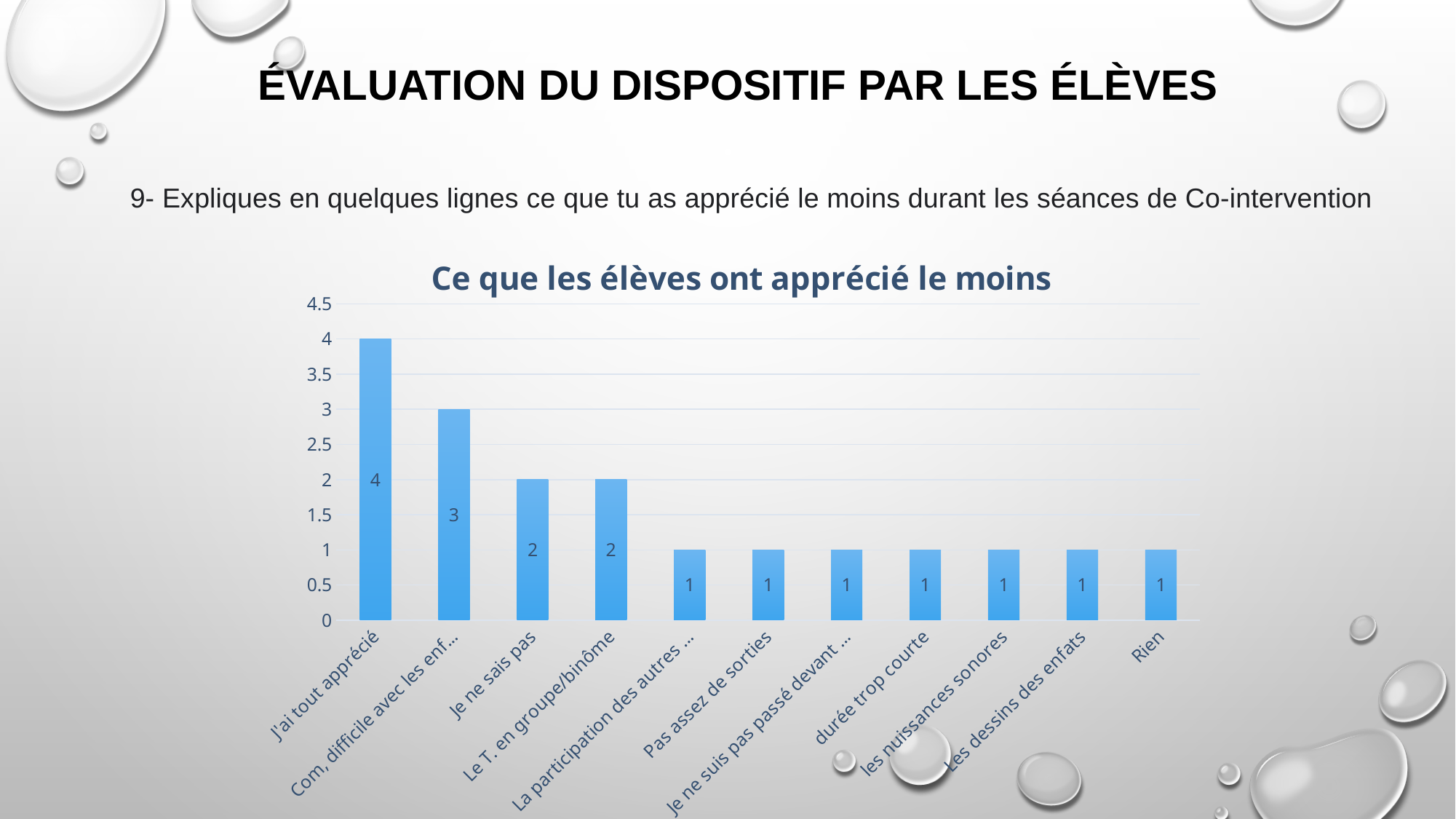
What is the value for "Le T. en groupe/binôme"? 2 Do the values rise or fall from left to right along the x axis? Fall How many categories are shown on the x axis? 11 What is the value for "Pas assez de sorties"? 1 Which category has the highest value? J'ai tout apprécié What is the value for "Je ne sais pas"? 2 What kind of chart is shown? Bar chart What is the title of the chart? Ce que les élèves ont apprécié le moins What is the difference between the values for "J'ai tout apprécié" and "Je ne sais pas"? 2 What is the value for "Rien"? 1 Which is larger, the value for "Je ne sais pas" or the value for "durée trop courte"? Je ne sais pas What is the value for "J'ai tout apprécié"? 4